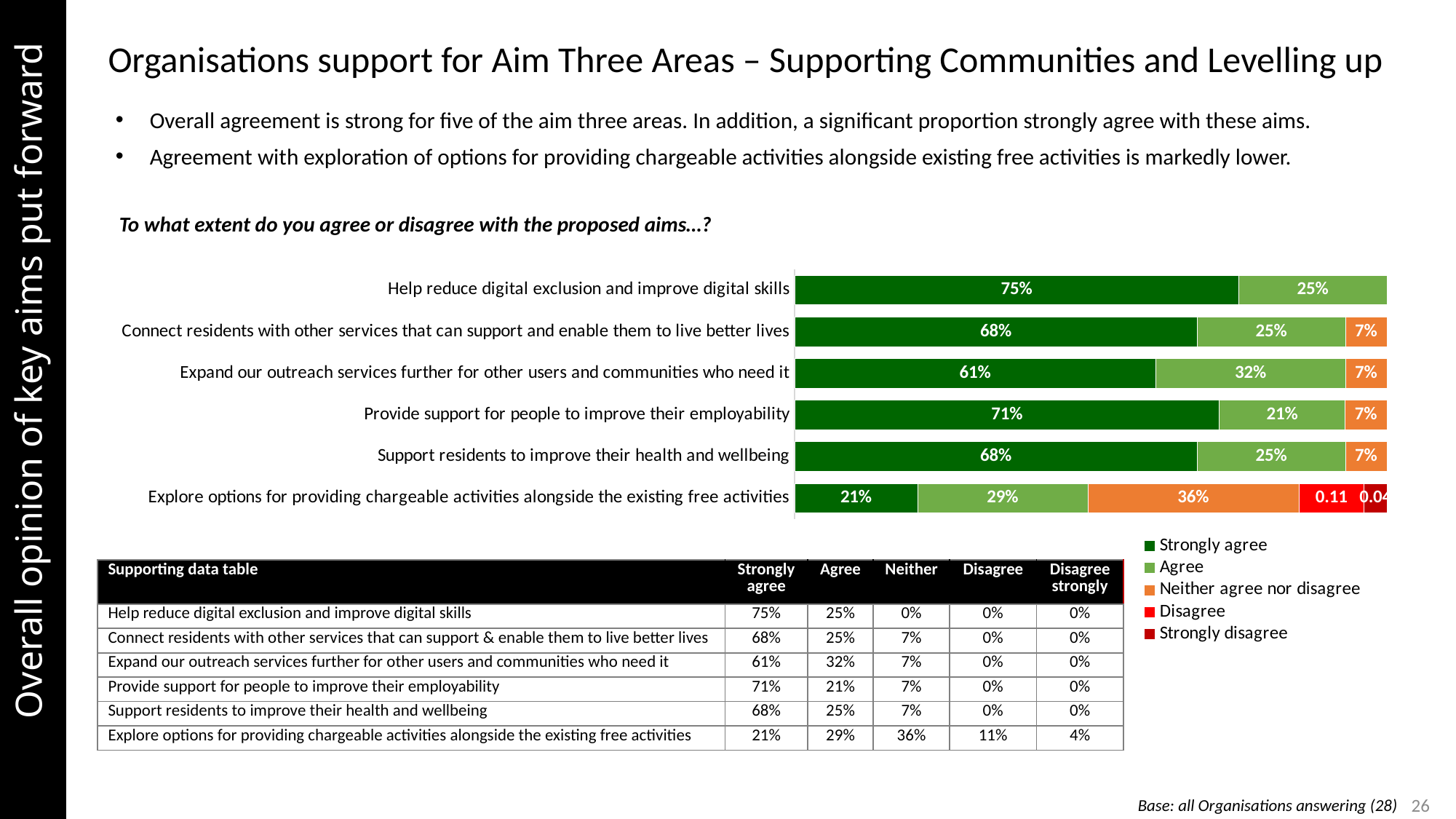
What percentage strongly agree with 'Help reduce digital exclusion and improve digital skills'? 75% What is the 'Neither agree nor disagree' value for 'Provide support for people to improve their employability'? 7% Which aim area has the highest 'Strongly agree' value? Help reduce digital exclusion and improve digital skills How many series does the chart legend list? 5 What is the difference in 'Strongly agree' between 'Help reduce digital exclusion and improve digital skills' and 'Expand our outreach services further for other users and communities who need it'? 14 percentage points Which has the larger 'Strongly agree' value: 'Provide support for people to improve their employability' or 'Support residents to improve their health and wellbeing'? Provide support for people to improve their employability What is the 'Agree' value for 'Expand our outreach services further for other users and communities who need it'? 32% What is the 'Neither agree nor disagree' value for 'Explore options for providing chargeable activities alongside the existing free activities'? 36% What kind of chart is shown on the slide? Stacked bar chart What is the combined total of 'Strongly agree' and 'Agree' for 'Help reduce digital exclusion and improve digital skills'? 100% Which aim area has the lowest 'Strongly agree' value? Explore options for providing chargeable activities alongside the existing free activities How many aim areas (categories) are plotted in the chart? 6